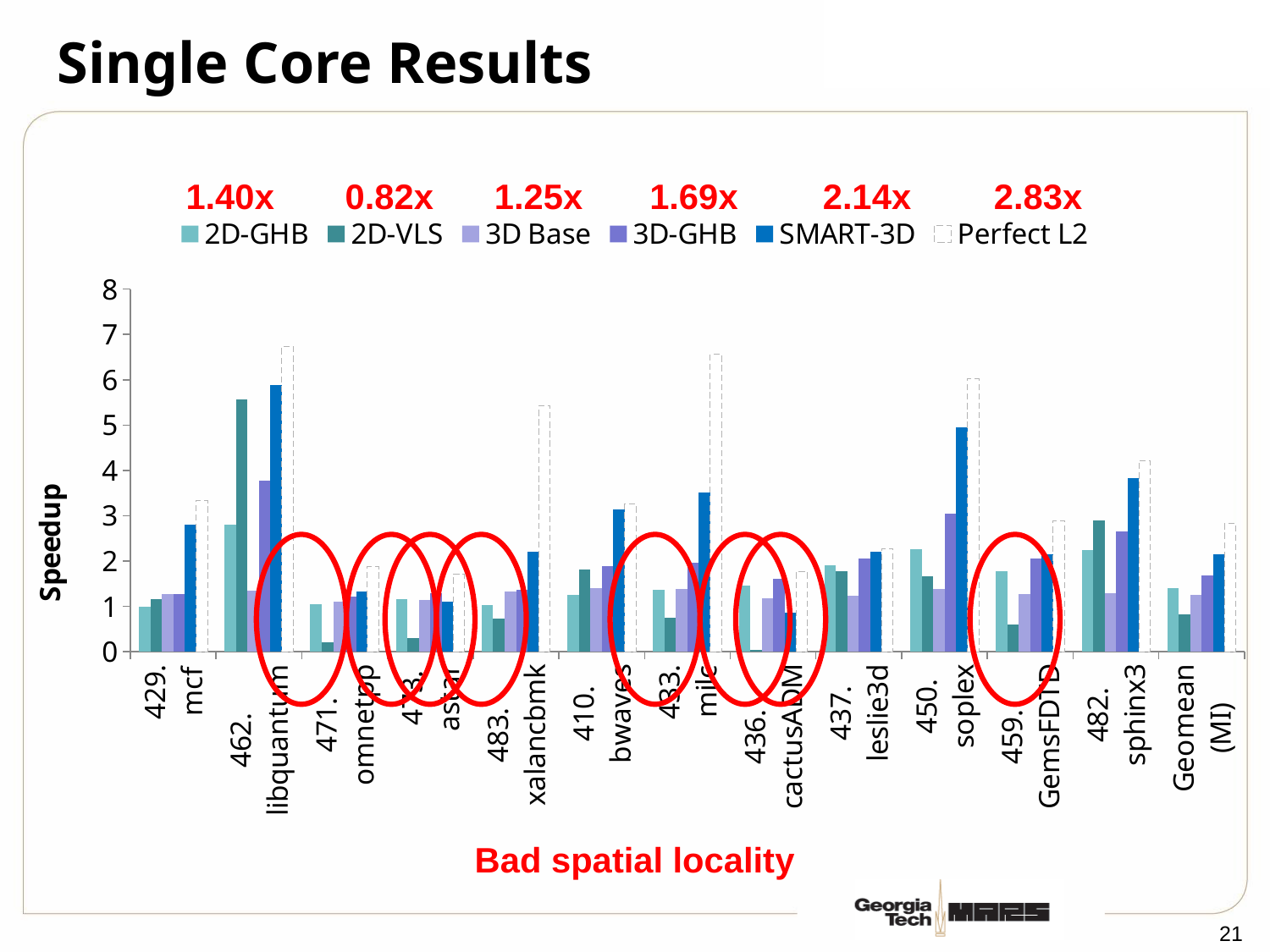
Is the 2D-VLS value for 471.omnetpp greater or less than 1? less How many categories are shown along the x axis? 13 How many series does the legend list? 6 What red value is printed above the SMART-3D legend entry? 2.14x Is the SMART-3D value for 450.soplex greater or less than 4? greater For 462.libquantum, which is larger: the 2D-VLS bar or the 2D-GHB bar? 2D-VLS Is the SMART-3D value for 462.libquantum greater or less than 5? greater What kind of chart is shown on the slide? bar chart Which series has the highest bar for 462.libquantum? Perfect L2 Which category has the highest SMART-3D bar? 462.libquantum What is the label of the y axis? Speedup